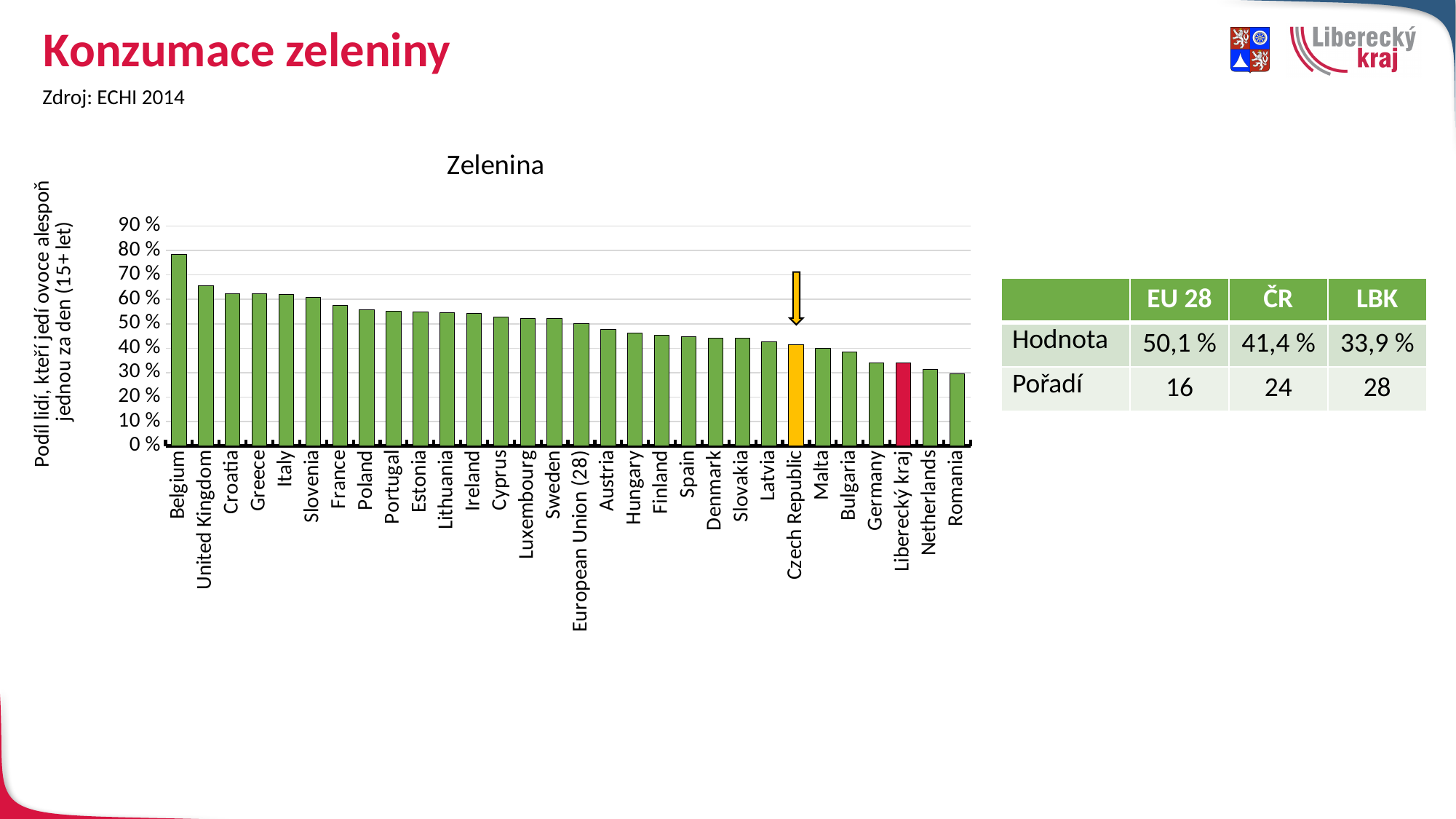
According to the table, what is the value for EU 28? 50,1 % Which category has the highest value in the chart? Belgium Is the value for Germany greater or less than 40 %? less According to the table, what is the value for Czech Republic (ČR)? 41,4 % Do the values rise or fall from left to right along the x axis? fall What is the title of the chart? Zelenina According to the table, what is the value for Liberecký kraj (LBK)? 33,9 % Which bar is larger, Czech Republic or Liberecký kraj? Czech Republic How many bars (categories) are plotted in the chart? 30 What type of chart is shown on the slide? bar chart Is the value for Belgium greater or less than 70 %? greater What is the difference between the values for ČR and LBK shown in the table? 7,5 %